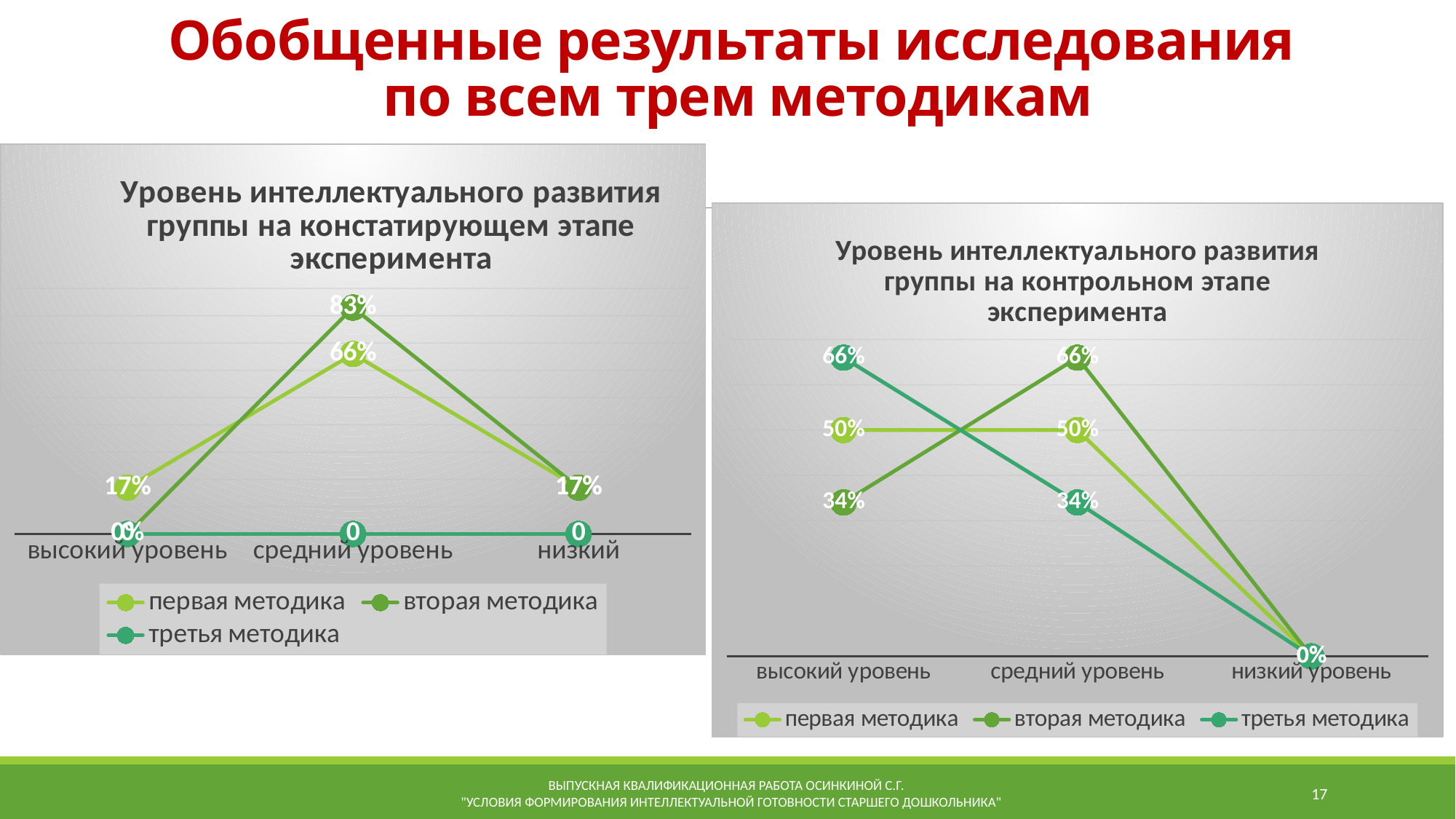
In the left chart (констатирующем этапе), what is the value for вторая методика at средний уровень? 83% In the right chart (контрольном этапе), what is the value for третья методика at высокий уровень? 66% In the right chart (контрольном этапе), does the value for третья методика rise or fall from высокий уровень to низкий уровень? fall In the right chart (контрольном этапе), which is larger at высокий уровень: третья методика or вторая методика? третья методика In the left chart (констатирующем этапе), what is the difference between вторая методика and первая методика at средний уровень? 17% In the left chart (констатирующем этапе), what is the value for первая методика at средний уровень? 66% In the left chart (констатирующем этапе), what is the value for первая методика at высокий уровень? 17% How many series does the legend of the right chart (контрольном этапе) list? 3 In the left chart (констатирующем этапе), at which category does вторая методика reach its highest value? средний уровень How many categories are shown on the x axis of the right chart (контрольном этапе)? 3 What kind of chart is the left chart, 'Уровень интеллектуального развития группы на констатирующем этапе эксперимента'? line chart In the right chart (контрольном этапе), what is the value for вторая методика at средний уровень? 66%